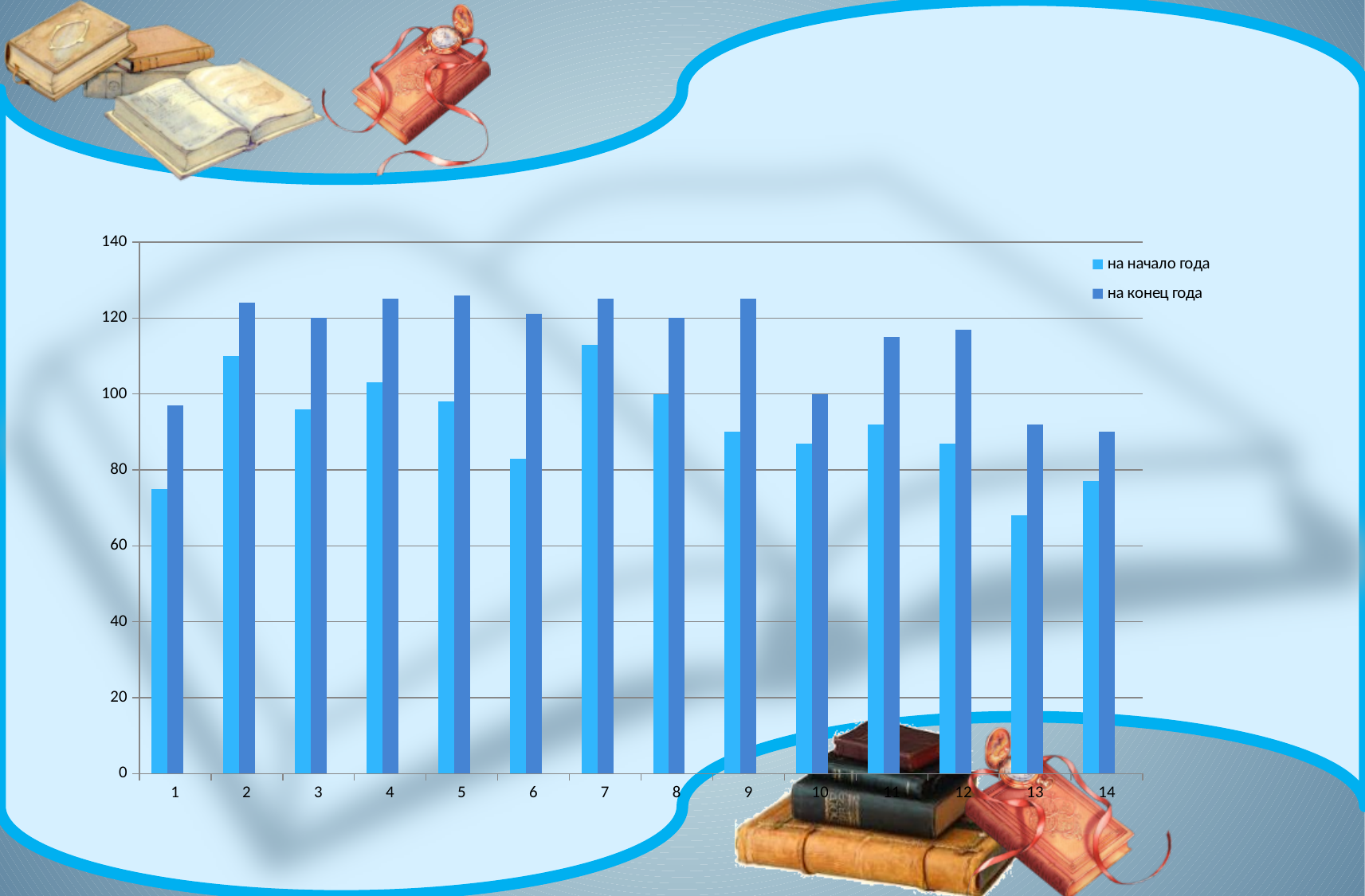
For category 1, which series has the larger value, 'на начало года' or 'на конец года'? на конец года Is the value for category 14 in the series 'на конец года' greater or less than 100? less How many categories are shown along the x axis of the chart? 14 How many series does the chart's legend list? 2 Is the value for category 2 in the series 'на конец года' greater or less than 120? greater What kind of chart is shown on the slide? bar chart What are the two series named in the chart's legend? на начало года, на конец года Is the value for category 7 in the series 'на начало года' greater or less than 100? greater In the series 'на начало года', which is larger, the value for category 2 or the value for category 13? category 2 Which category has the lowest value for the series 'на начало года'? 13 Which series is drawn in the lighter blue colour? на начало года